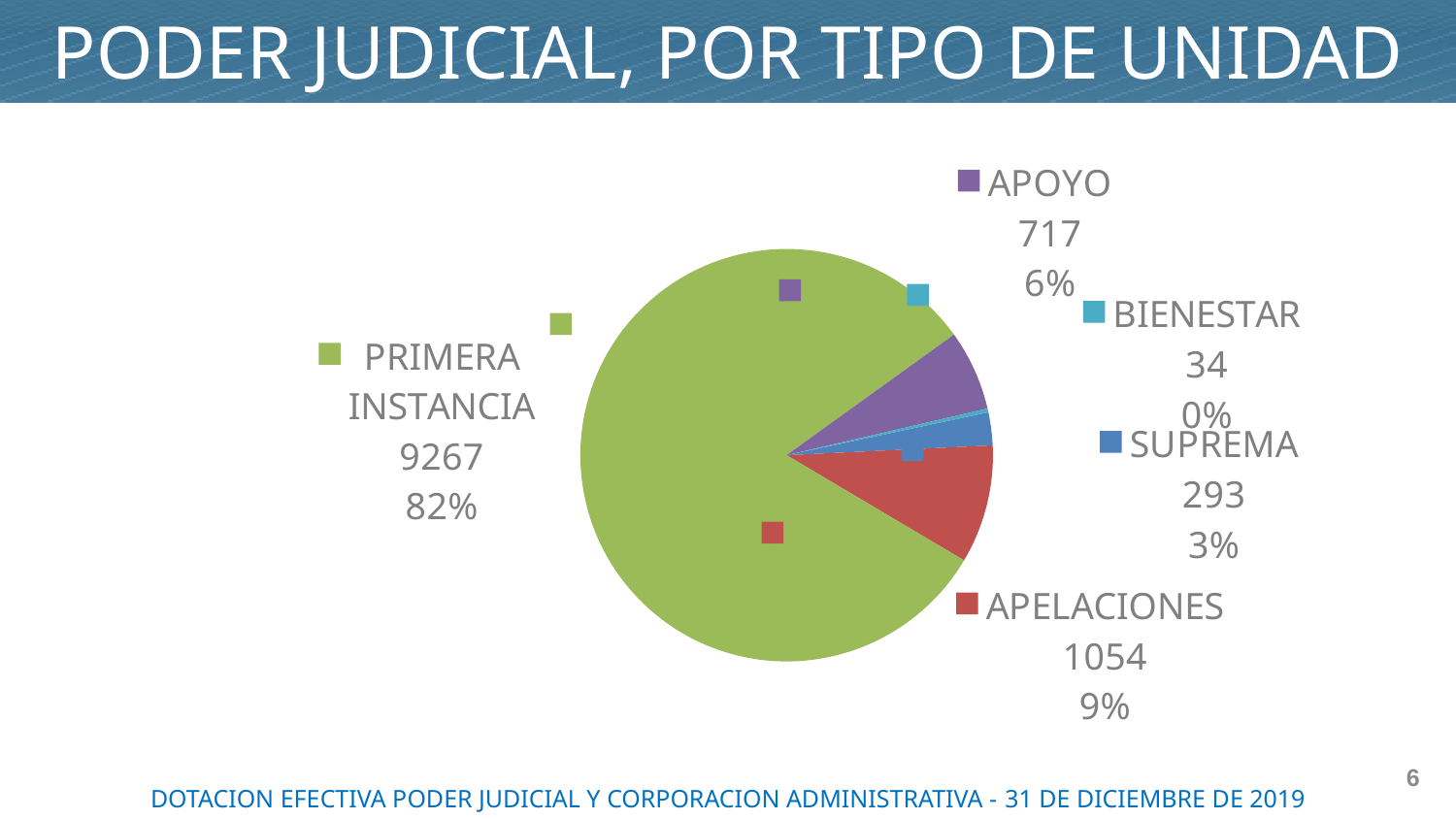
What is the value for BIENESTAR? 34 What is the value for SUPREMA? 293 Which is larger, the value for SUPREMA or the value for APOYO? APOYO Which category has the largest slice of the pie? PRIMERA INSTANCIA What is the difference between the values for APELACIONES and APOYO? 337 What share of the pie does APOYO represent? 6% How many categories does the pie chart show? 5 What kind of chart is shown on the slide? pie chart What is the value for PRIMERA INSTANCIA? 9267 Which category has the smallest slice of the pie? BIENESTAR What is the value for APELACIONES? 1054 What share of the pie does PRIMERA INSTANCIA represent? 82%